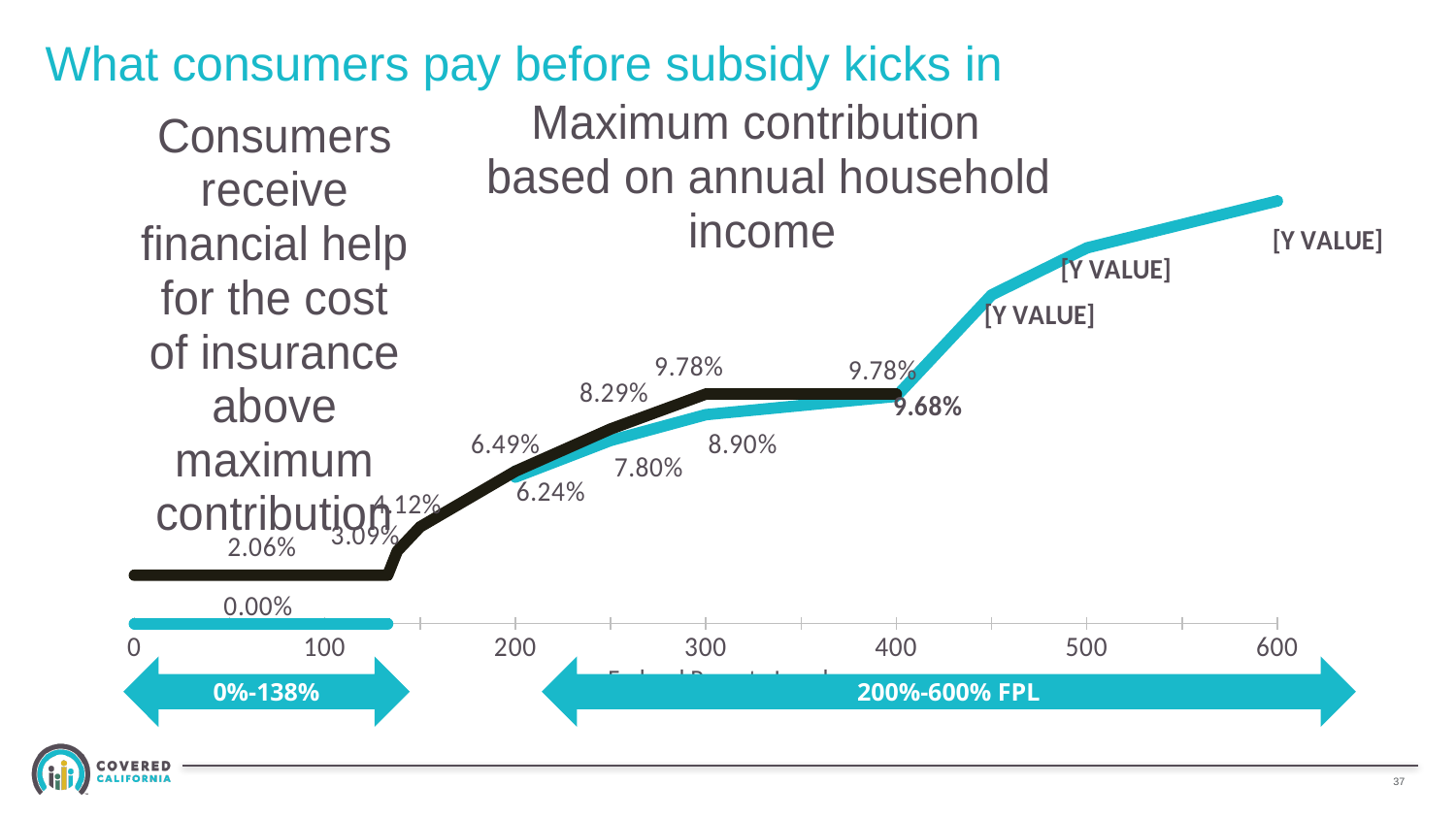
Does the teal line generally rise or fall as the x-axis value increases from 0 to 600? Rise What value is labeled on the teal line at 400 on the x axis? 9.68% What value is labeled on the black line at 200 on the x axis? 6.49% What is the highest tick value shown on the x axis? 600 What is the difference between the black line's 9.78% and the teal line's 8.90% at 300 on the x axis? 0.88 percentage points How many data labels on the teal line show the placeholder text "[Y VALUE]"? 3 What type of chart is shown on the slide? Line chart What is the title of the chart? Maximum contribution based on annual household income What is the lowest value labeled on the teal (light blue) line? 0.00% What is the highest value labeled on the black line? 9.78% At 300 on the x axis, which line has the higher labeled value, the black line or the teal line? The black line What value is labeled on the teal line at 300 on the x axis? 8.90%